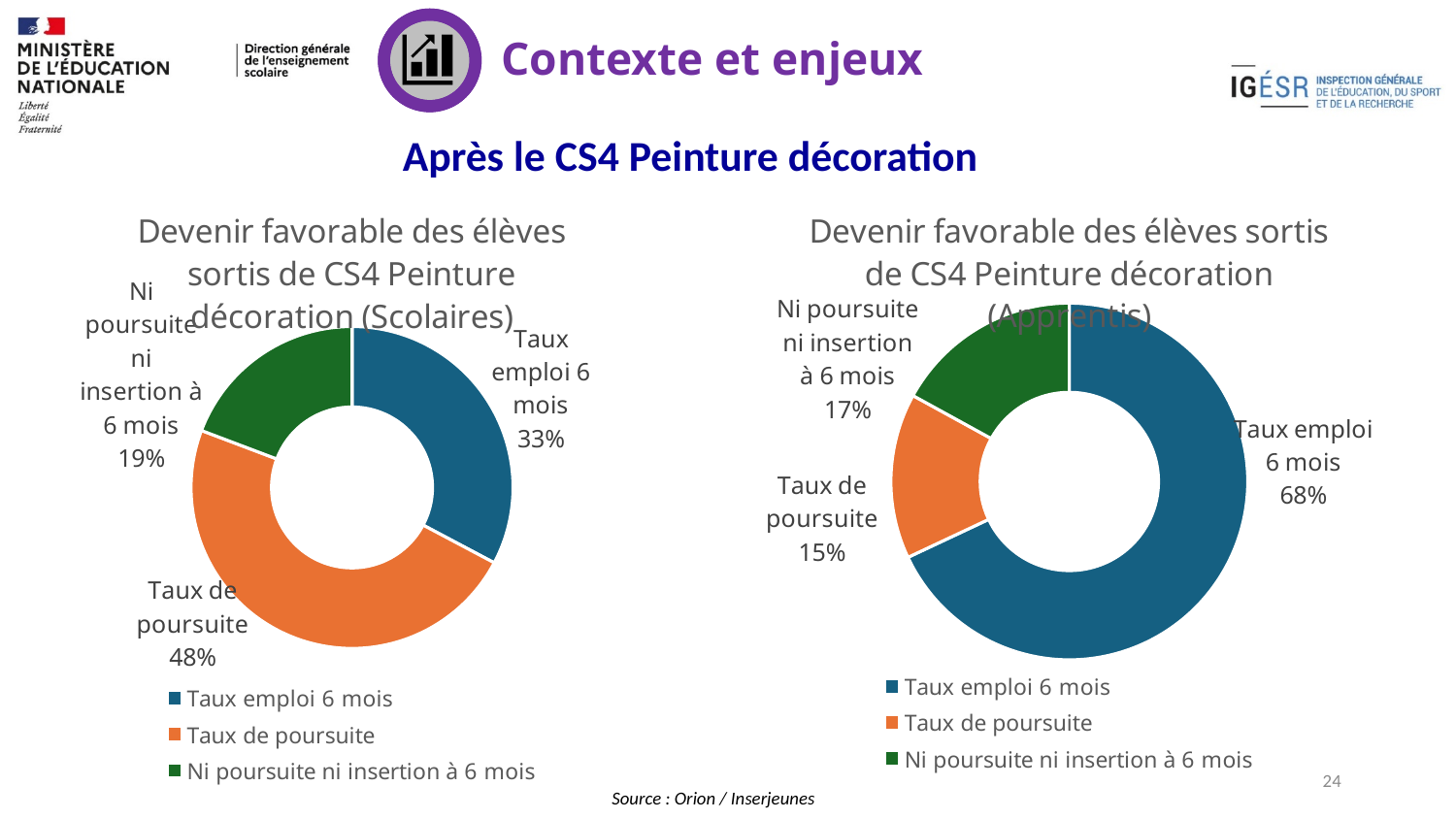
In the left chart (Scolaires), which is larger: Taux emploi 6 mois or Ni poursuite ni insertion à 6 mois? Taux emploi 6 mois In the right chart (Apprentis), what is the value for Taux emploi 6 mois? 68% In the left chart (Scolaires), what is the value for Taux de poursuite? 48% What type of chart is used on the left of the slide? Doughnut (pie) chart In the left chart (Scolaires), what is the value for Ni poursuite ni insertion à 6 mois? 19% In the left chart (Scolaires), which category has the largest share? Taux de poursuite What colour represents Ni poursuite ni insertion à 6 mois in the legends of both charts? Green What is the difference between Taux emploi 6 mois in the right chart (Apprentis) and Taux emploi 6 mois in the left chart (Scolaires)? 35 percentage points How many categories does the right chart (Apprentis) show? 3 In the right chart (Apprentis), what is the value for Taux de poursuite? 15% In the left chart (Scolaires), what is the difference between Taux de poursuite and Taux emploi 6 mois? 15 percentage points In the right chart (Apprentis), which category has the smallest share? Taux de poursuite